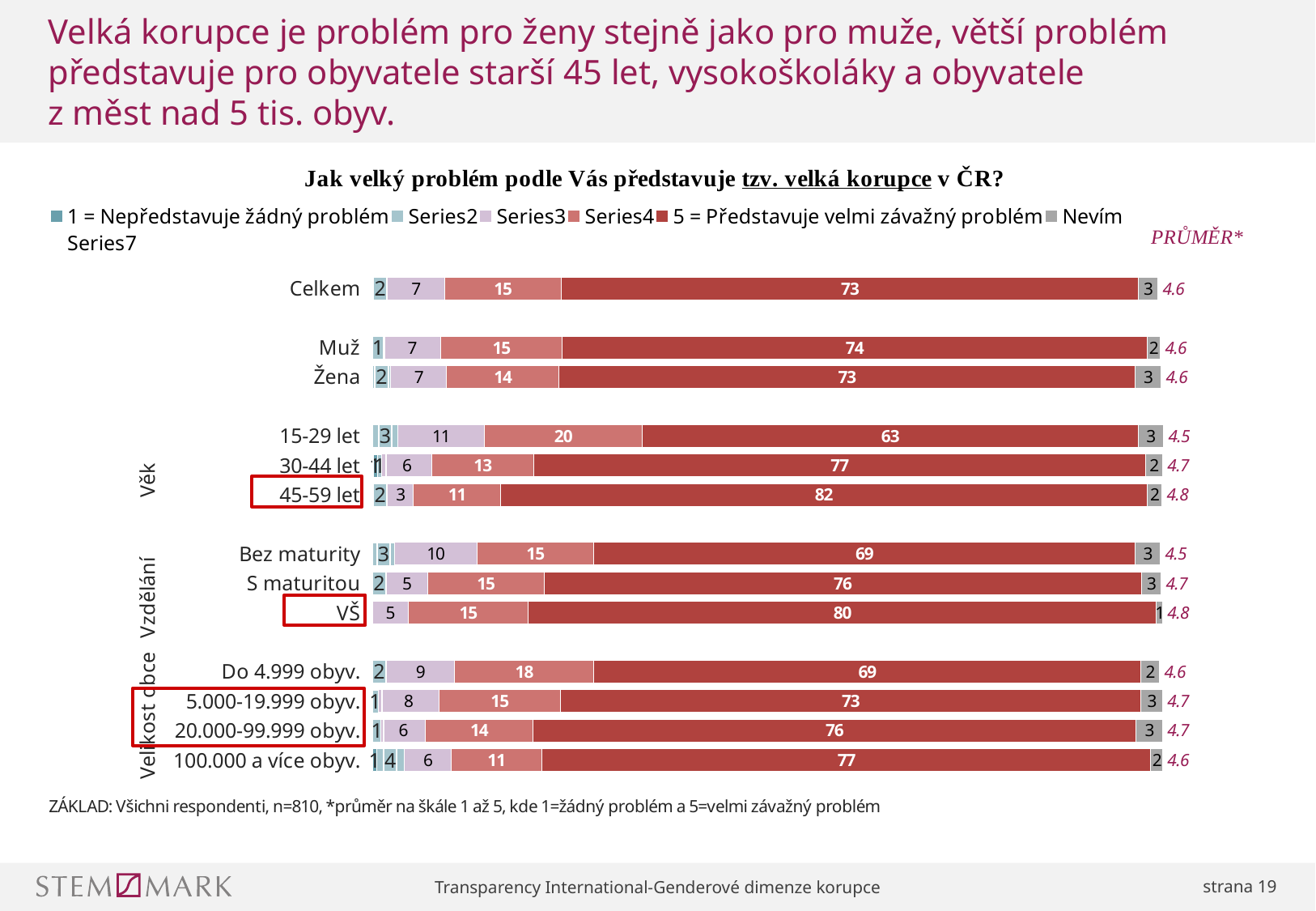
What is the Series4 value for 15-29 let? 20 What type of chart is shown on the slide? stacked bar chart How many series does the legend list? 7 What is the title of the chart? Jak velký problém podle Vás představuje tzv. velká korupce v ČR? What is the PRŮMĚR value shown for VŠ? 4.8 Which category has the highest value for '5 = Představuje velmi závažný problém'? 45-59 let How many categories (rows) are plotted in the chart? 13 Which category has the lowest value for '5 = Představuje velmi závažný problém'? 15-29 let What is the value of '5 = Představuje velmi závažný problém' for Celkem? 73 What is the difference between the '5 = Představuje velmi závažný problém' values for 45-59 let and 15-29 let? 19 What is the value of '5 = Představuje velmi závažný problém' for 45-59 let? 82 Which has a larger value for '5 = Představuje velmi závažný problém': VŠ or Bez maturity? VŠ